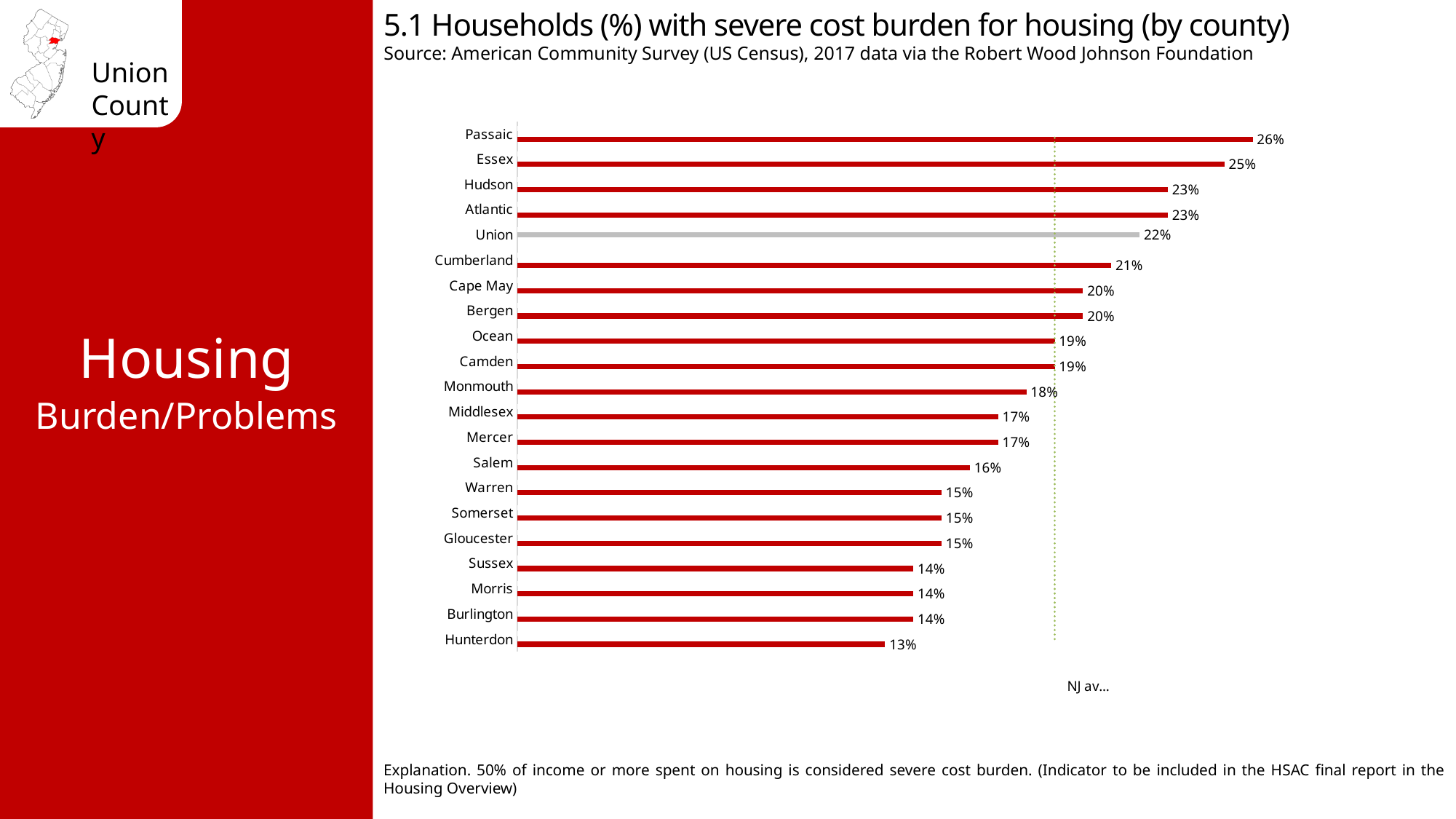
What is the value for Union? 22% What is the difference between the values for Passaic and Hunterdon? 13% Which county's bar is shown in grey rather than red? Union What is the value for Passaic? 26% What is the value for Hunterdon? 13% What is the difference between the values for Essex and Union? 3% Which county has the highest value? Passaic What kind of chart is this? Bar chart What is the value for Cumberland? 21% Which is larger, the value for Hudson or the value for Salem? Hudson How many counties are shown in the chart? 21 Which county has the lowest value? Hunterdon